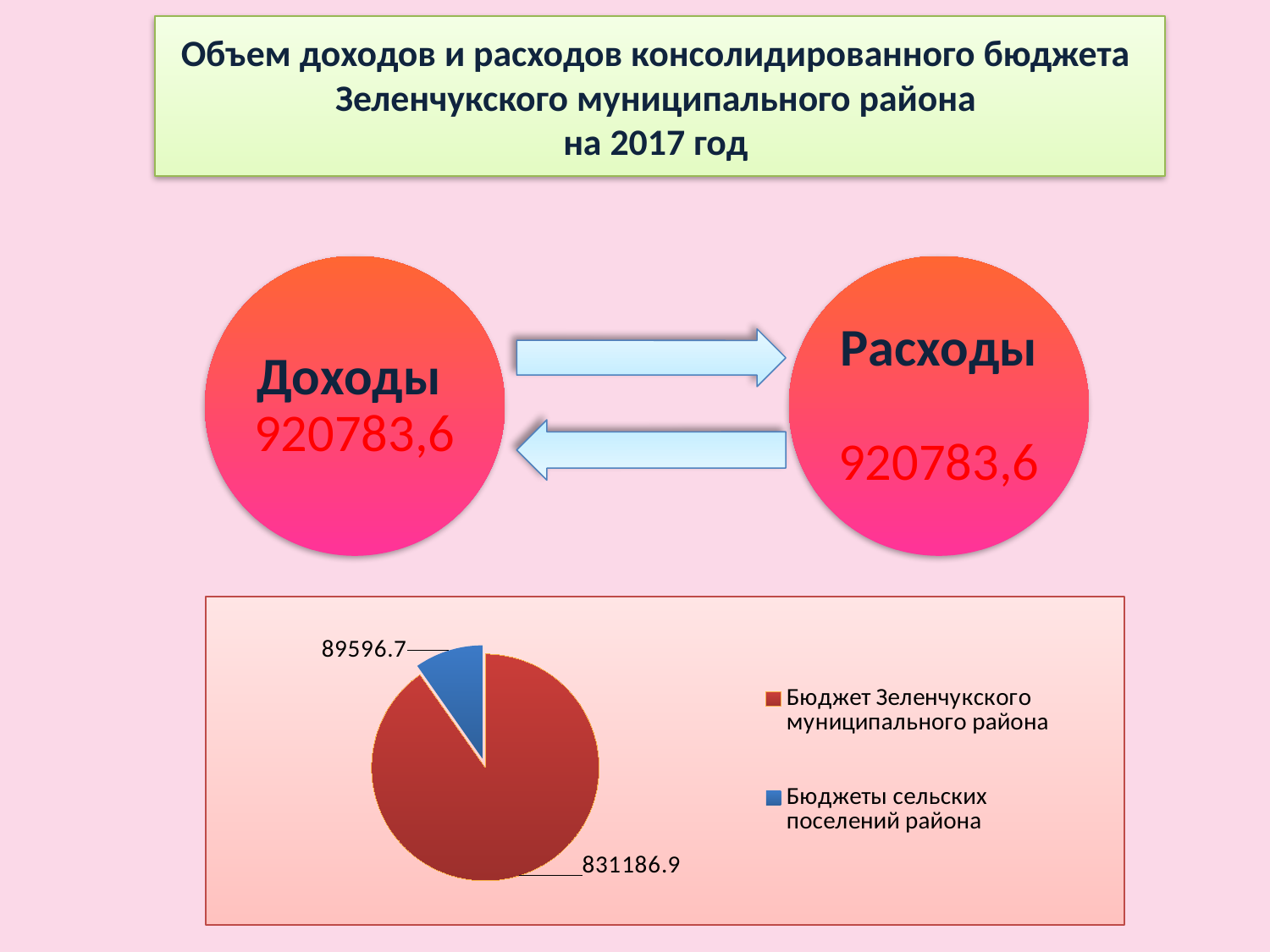
In the pie chart, which is larger: Бюджет Зеленчукского муниципального района or Бюджеты сельских поселений района? Бюджет Зеленчукского муниципального района Which slice of the pie chart is the largest? Бюджет Зеленчукского муниципального района In the pie chart, what is the value for Бюджет Зеленчукского муниципального района? 831186.9 What is the total of the two values shown in the pie chart? 920783.6 Which slice of the pie chart is the smallest? Бюджеты сельских поселений района In the pie chart, what is the value for Бюджеты сельских поселений района? 89596.7 How many slices does the pie chart have? 2 How many entries does the legend of the pie chart list? 2 What colour is the slice for Бюджеты сельских поселений района in the pie chart? blue In the pie chart, what is the difference between the value for Бюджет Зеленчукского муниципального района and the value for Бюджеты сельских поселений района? 741590.2 What type of chart is shown at the bottom of the slide? pie chart